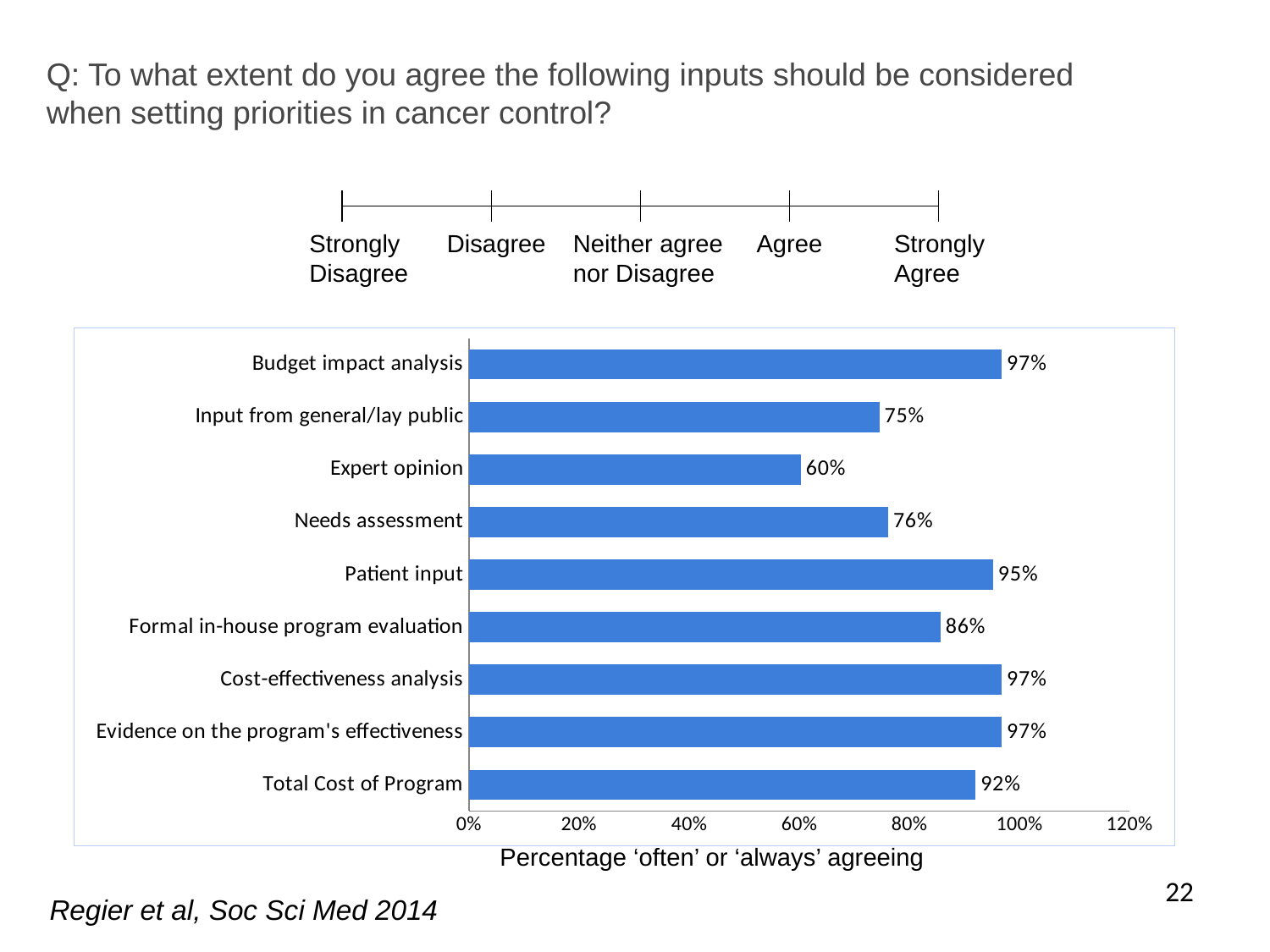
What is the value for Formal in-house program evaluation? 86% Which input has the lowest percentage agreeing? Expert opinion What is the difference between the values for Needs assessment and Input from general/lay public? 1% Which is larger, the value for Patient input or the value for Formal in-house program evaluation? Patient input How many inputs (categories) are plotted on the chart? 9 What percentage is shown for Expert opinion? 60% What is the label on the horizontal axis of the chart? Percentage ‘often’ or ‘always’ agreeing What is the highest percentage value shown on the chart? 97% What is the value for Patient input? 95% What percentage is shown for Total Cost of Program? 92% What is the difference between the values for Budget impact analysis and Expert opinion? 37% What kind of chart is shown on the slide? Bar chart